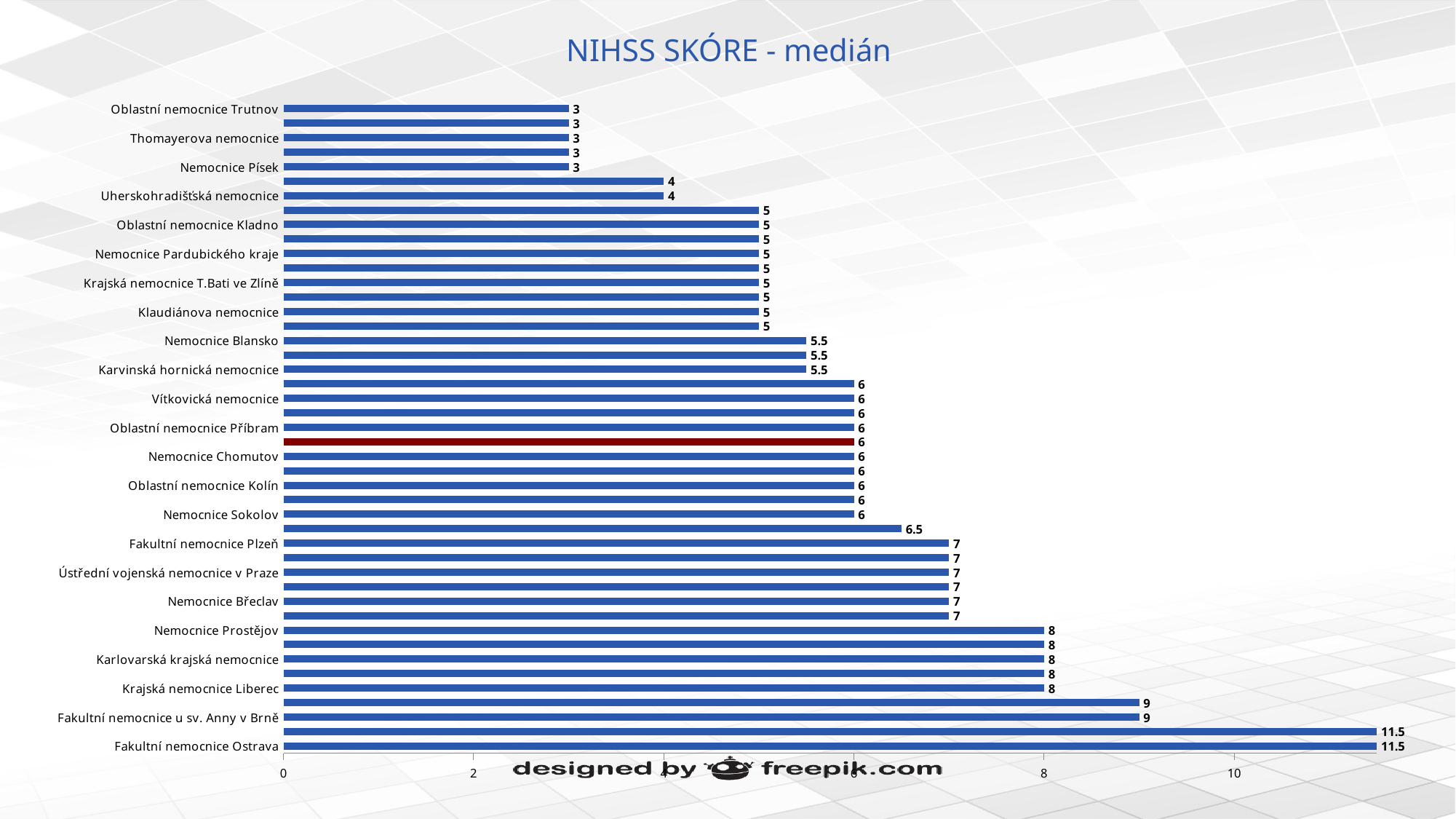
Which has a higher value, Nemocnice Prostějov or Nemocnice Břeclav? Nemocnice Prostějov What is the NIHSS median score for Fakultní nemocnice Ostrava? 11.5 Is the value for Fakultní nemocnice Plzeň greater or less than 6? greater What is the value shown for Nemocnice Blansko? 5.5 What is the highest value shown on the chart? 11.5 What is the value shown for Oblastní nemocnice Trutnov? 3 What is the value of the bar highlighted in dark red? 6 What is the lowest value shown on the chart? 3 What is the difference between the values for Fakultní nemocnice Ostrava and Fakultní nemocnice u sv. Anny v Brně? 2.5 What is the title of the chart? NIHSS SKÓRE - medián What is the value shown for Krajská nemocnice Liberec? 8 What kind of chart is shown on the slide? bar chart